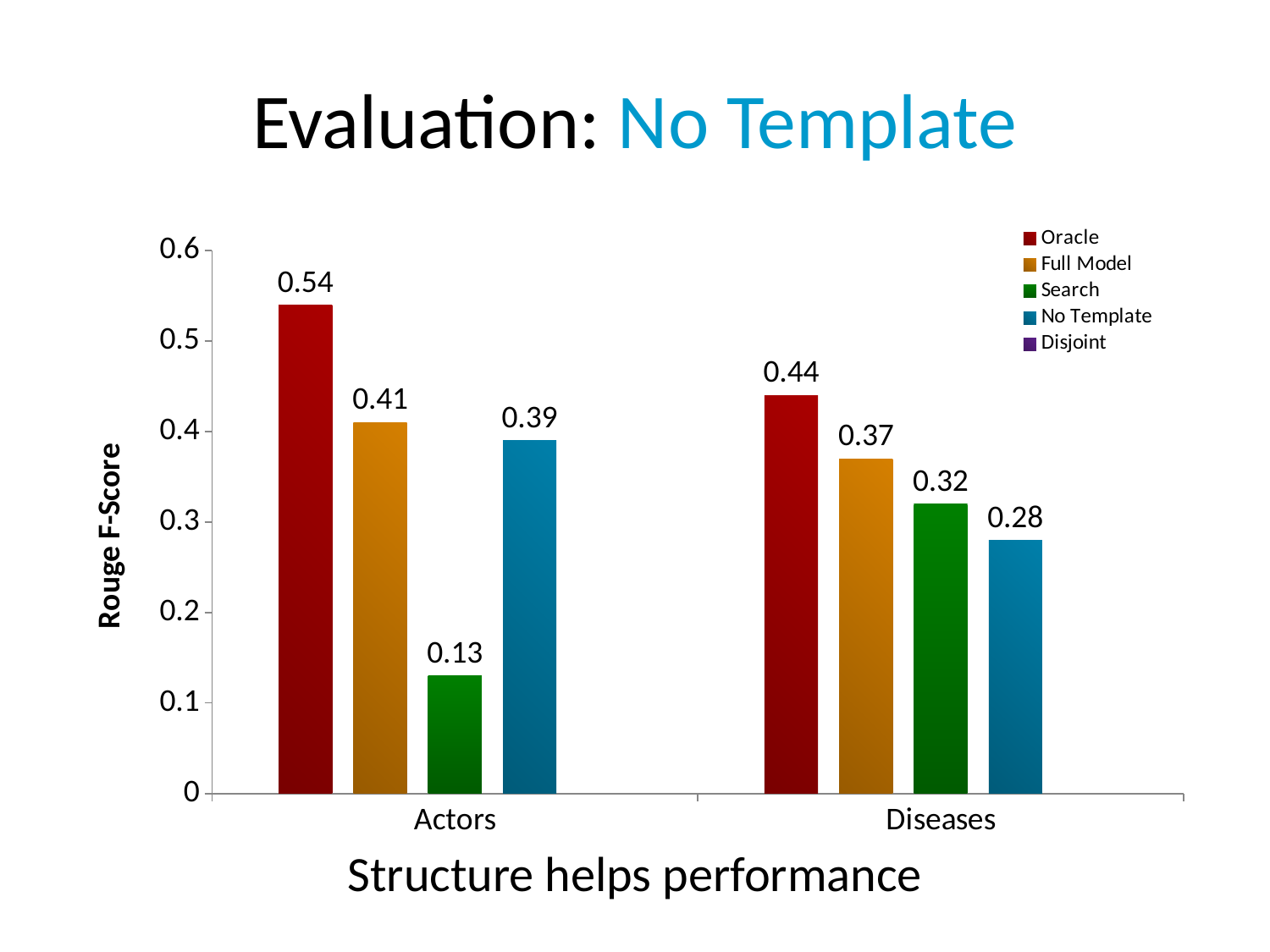
Which is larger for Diseases: the Search score or the No Template score? Search What is the label on the vertical axis? Rouge F-Score What is the Rouge F-Score for Search on Actors? 0.13 How many series does the legend list? 5 What kind of chart is shown on the slide? Bar chart Which series has the lowest Rouge F-Score for Actors? Search What is the Rouge F-Score for No Template on Diseases? 0.28 What is the Rouge F-Score for Full Model on Diseases? 0.37 Is the Full Model value for Actors greater or less than 0.3? greater What is the Rouge F-Score for Oracle on Actors? 0.54 Which series has the highest Rouge F-Score for Diseases? Oracle What is the difference between the Oracle and Full Model scores for Actors? 0.13